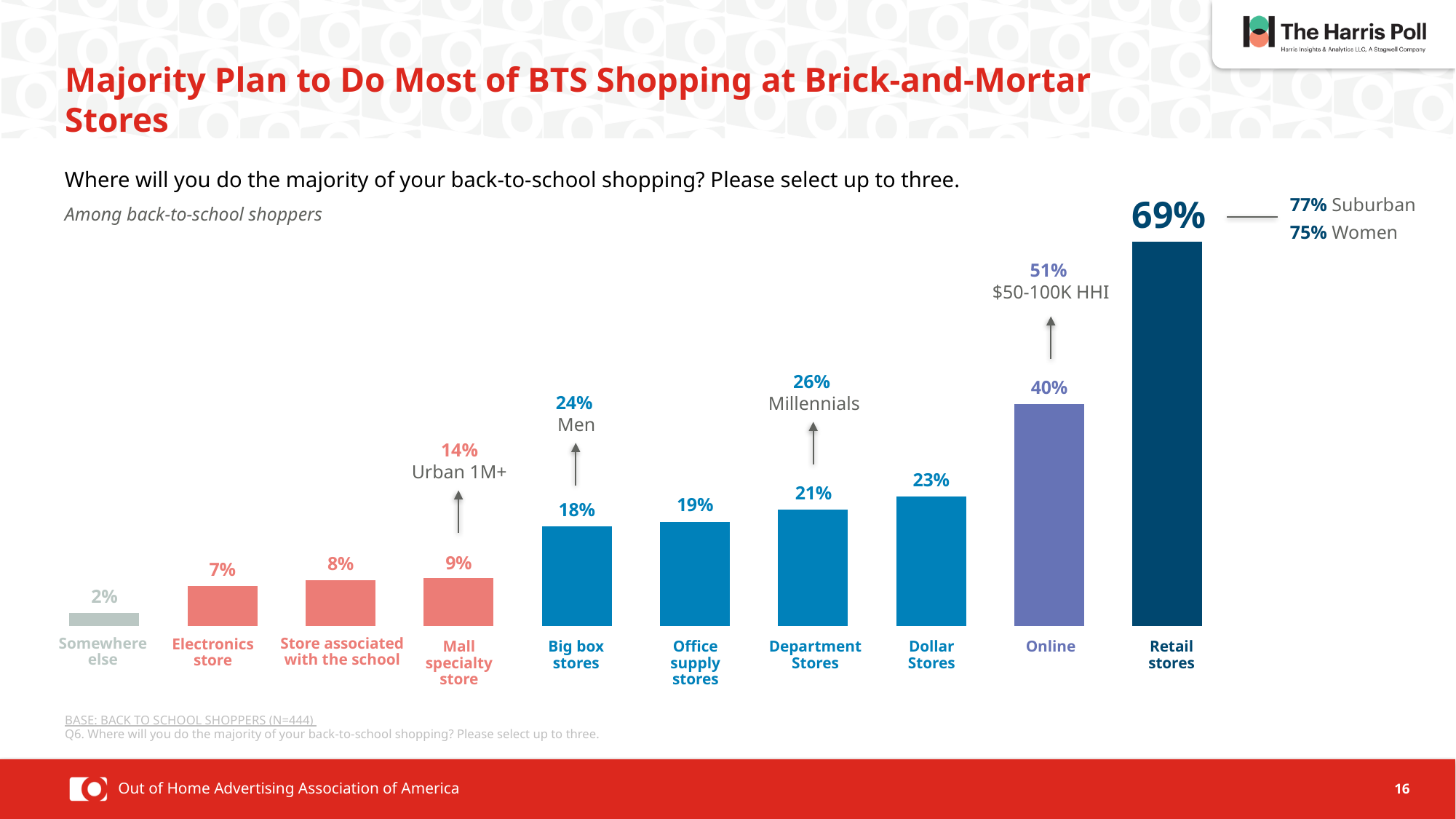
What percentage of Millennials is called out above the Department Stores bar? 26% Do the values rise or fall moving from left to right along the x axis? Rise Which category has the lowest value in the chart? Somewhere else What is the difference between the values for Department Stores and Big box stores? 3% What percentage of back-to-school shoppers plan to do the majority of their shopping at retail stores? 69% What is the difference between the values for Retail stores and Online? 29% What is the value shown for Online? 40% What kind of chart is shown on the slide? Bar chart Which is larger, the value for Office supply stores or the value for Electronics store? Office supply stores How many categories are shown in the chart? 10 Which category has the highest value in the chart? Retail stores What is the value shown for Dollar Stores? 23%